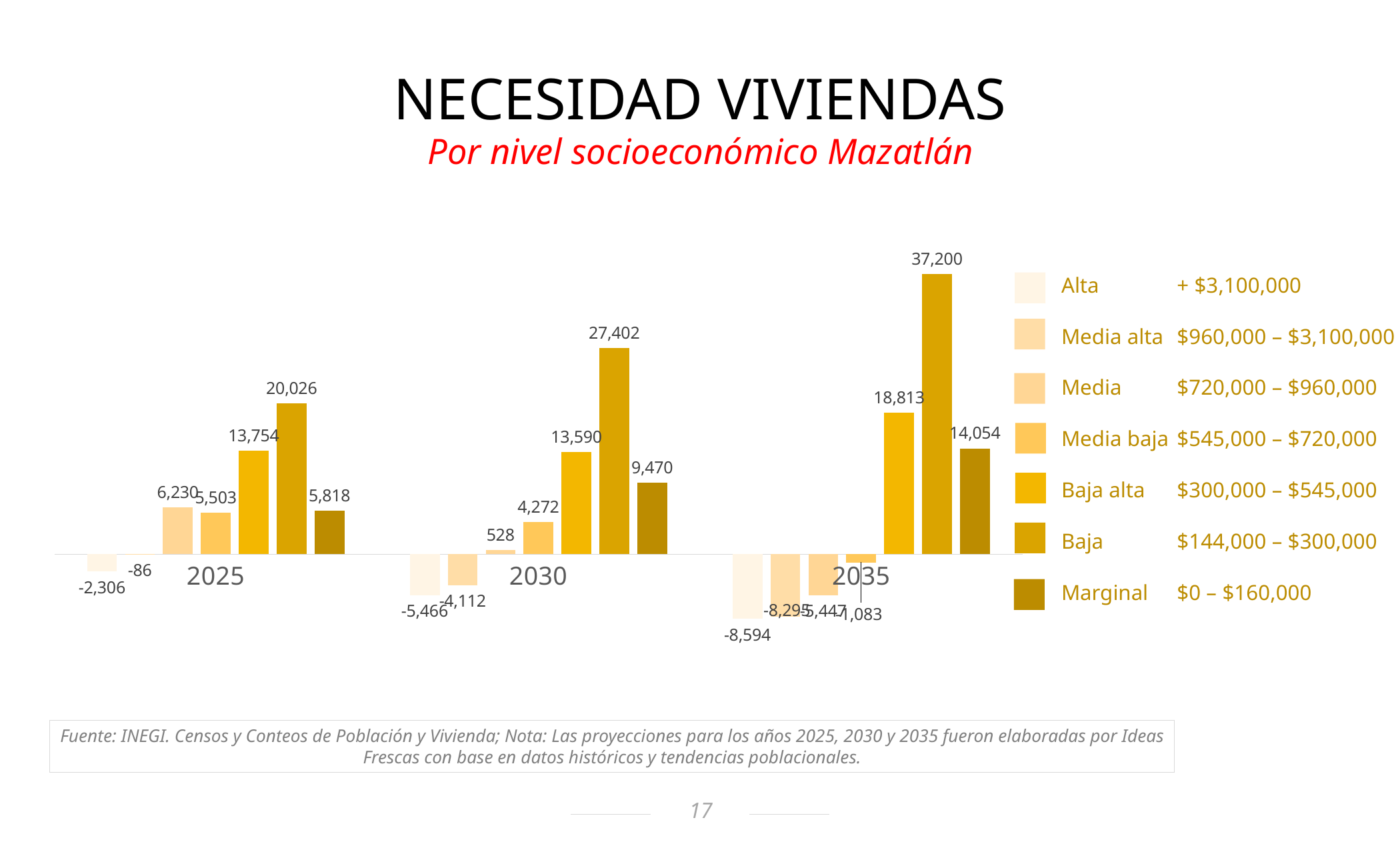
Which is larger, the Marginal value for 2025 or for 2035? 2035 What kind of chart is shown on the slide? Bar chart What is the value for Baja alta in 2025? 13,754 How many series does the legend list? 7 What is the value for Marginal in 2030? 9,470 In which year is the Baja series highest? 2035 Does the Baja series rise or fall from 2025 to 2035? Rises How many years are shown on the x axis? 3 What is the difference between the Baja values for 2035 and 2030? 9,798 What is the value for Alta in 2035? -8,594 What is the value for Baja in 2035? 37,200 Which series has the lowest value in 2030? Alta